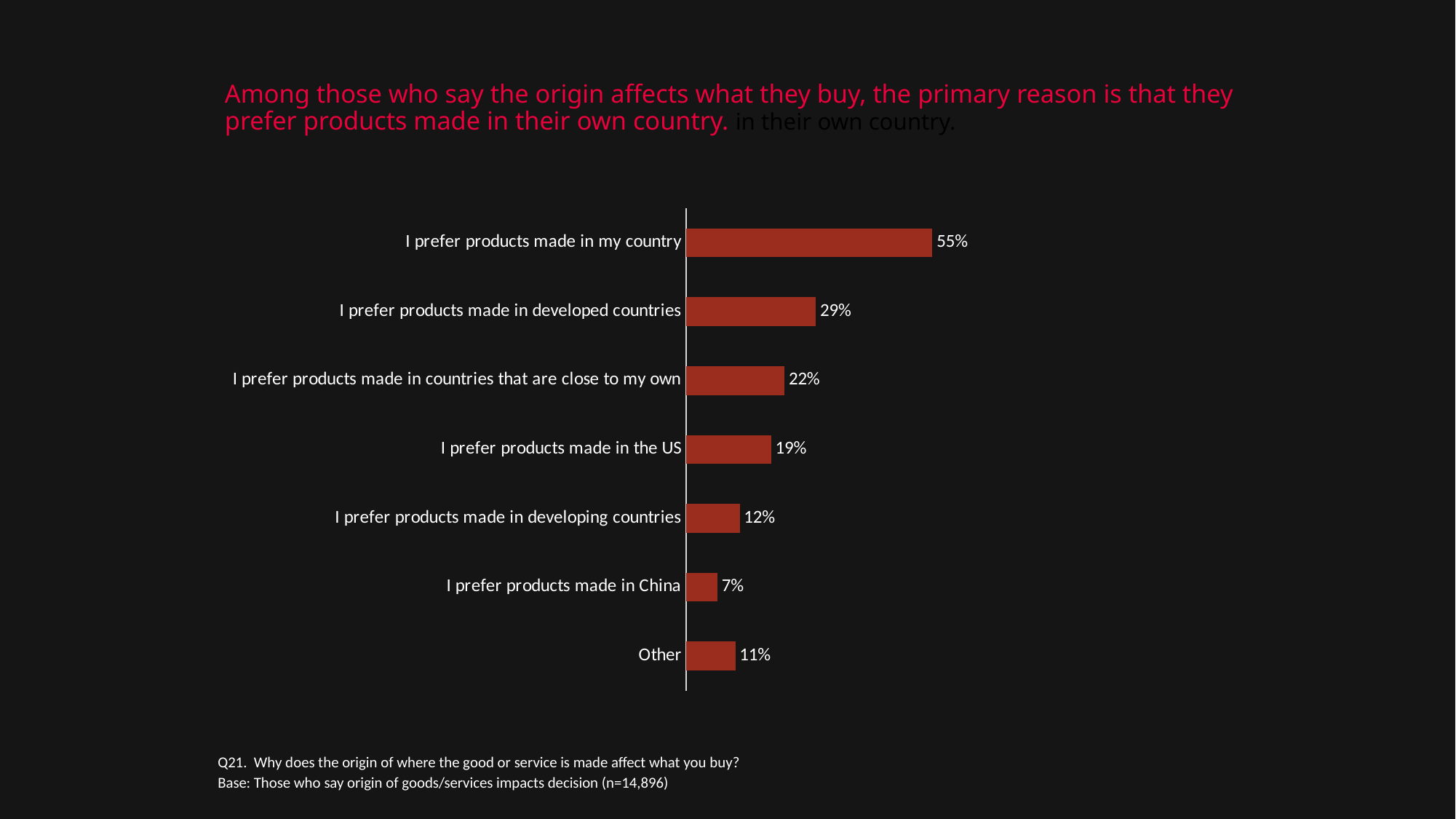
Which is larger: the value for "I prefer products made in developing countries" or the value for "Other"? I prefer products made in developing countries Which reason has the highest percentage? I prefer products made in my country What is the difference between the percentage preferring products made in their own country and the percentage preferring products made in developed countries? 26 percentage points What is the difference between the values for "I prefer products made in countries that are close to my own" and "I prefer products made in the US"? 3 percentage points How many categories are shown in the chart? 7 Which reason has the lowest percentage? I prefer products made in China What kind of chart is shown on the slide? Bar chart What percentage say they prefer products made in the US? 19% What is the base size (n) stated below the chart? n=14,896 What is the value for "I prefer products made in China"? 7% What percentage of respondents say they prefer products made in their own country? 55% What is the value for "I prefer products made in developed countries"? 29%